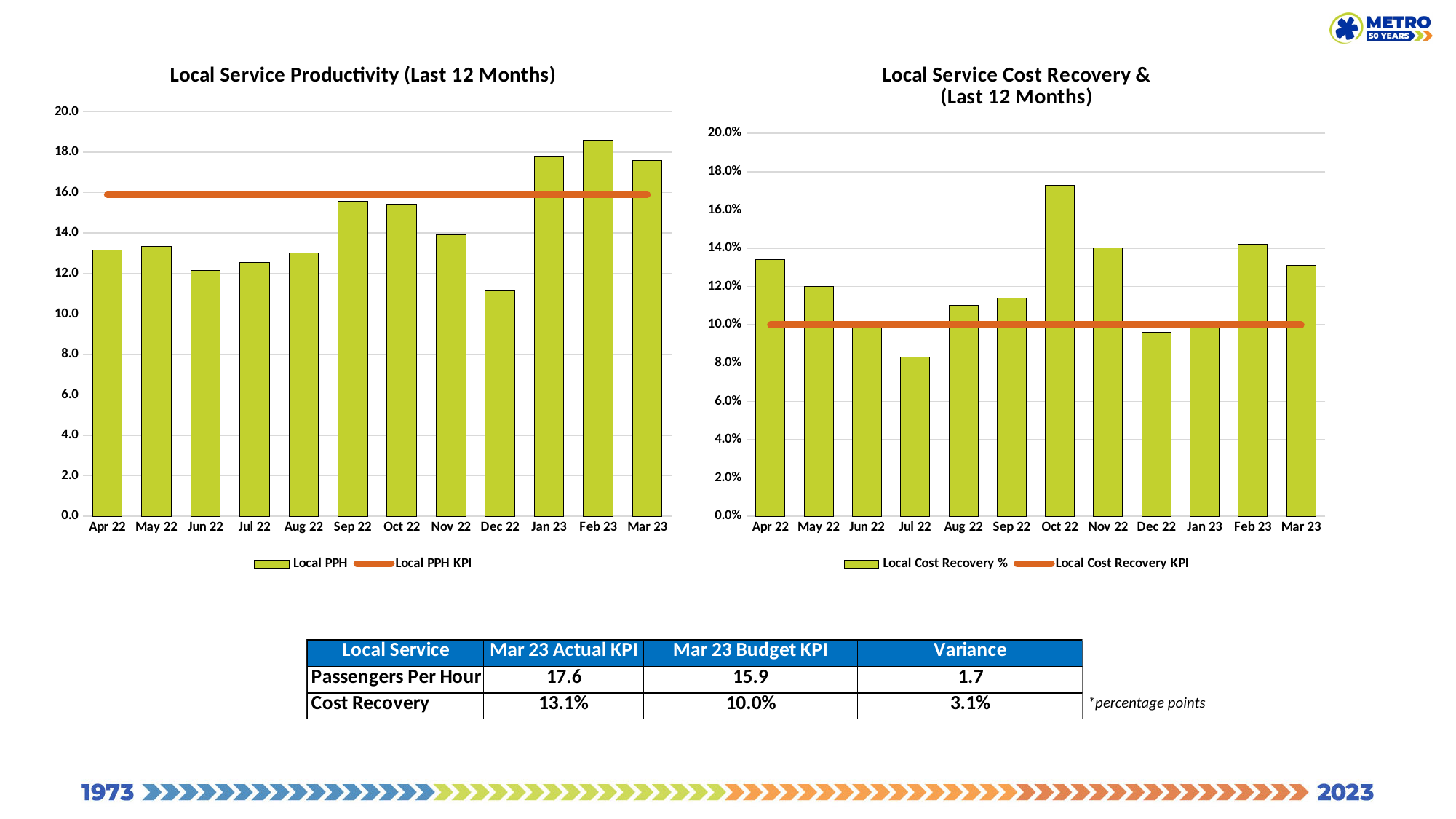
In the Local Service Productivity (Last 12 Months) chart, is the Local PPH value for Dec 22 greater or less than 12.0? less In the Local Service Productivity (Last 12 Months) chart, is the Local PPH value for Jan 23 greater or less than 16.0? greater How many months are shown on the x axis of the Local Service Productivity (Last 12 Months) chart? 12 What does the orange line in the Local Service Cost Recovery & (Last 12 Months) chart represent, according to the legend? Local Cost Recovery KPI In the Local Service Cost Recovery & (Last 12 Months) chart, which is larger, the Local Cost Recovery % for Oct 22 or for Jan 23? Oct 22 In the Local Service Cost Recovery & (Last 12 Months) chart, which month has the highest Local Cost Recovery % bar? Oct 22 In the Local Service Cost Recovery & (Last 12 Months) chart, is the Local Cost Recovery % value for Jul 22 greater or less than 10.0%? less In the Local Service Cost Recovery & (Last 12 Months) chart, which month has the lowest Local Cost Recovery % bar? Jul 22 What type of chart is the Local Service Productivity (Last 12 Months) chart? bar chart In the Local Service Productivity (Last 12 Months) chart, which month has the lowest Local PPH bar? Dec 22 In the Local Service Productivity (Last 12 Months) chart, which month has the highest Local PPH bar? Feb 23 How many series does the legend of the Local Service Productivity (Last 12 Months) chart list? 2